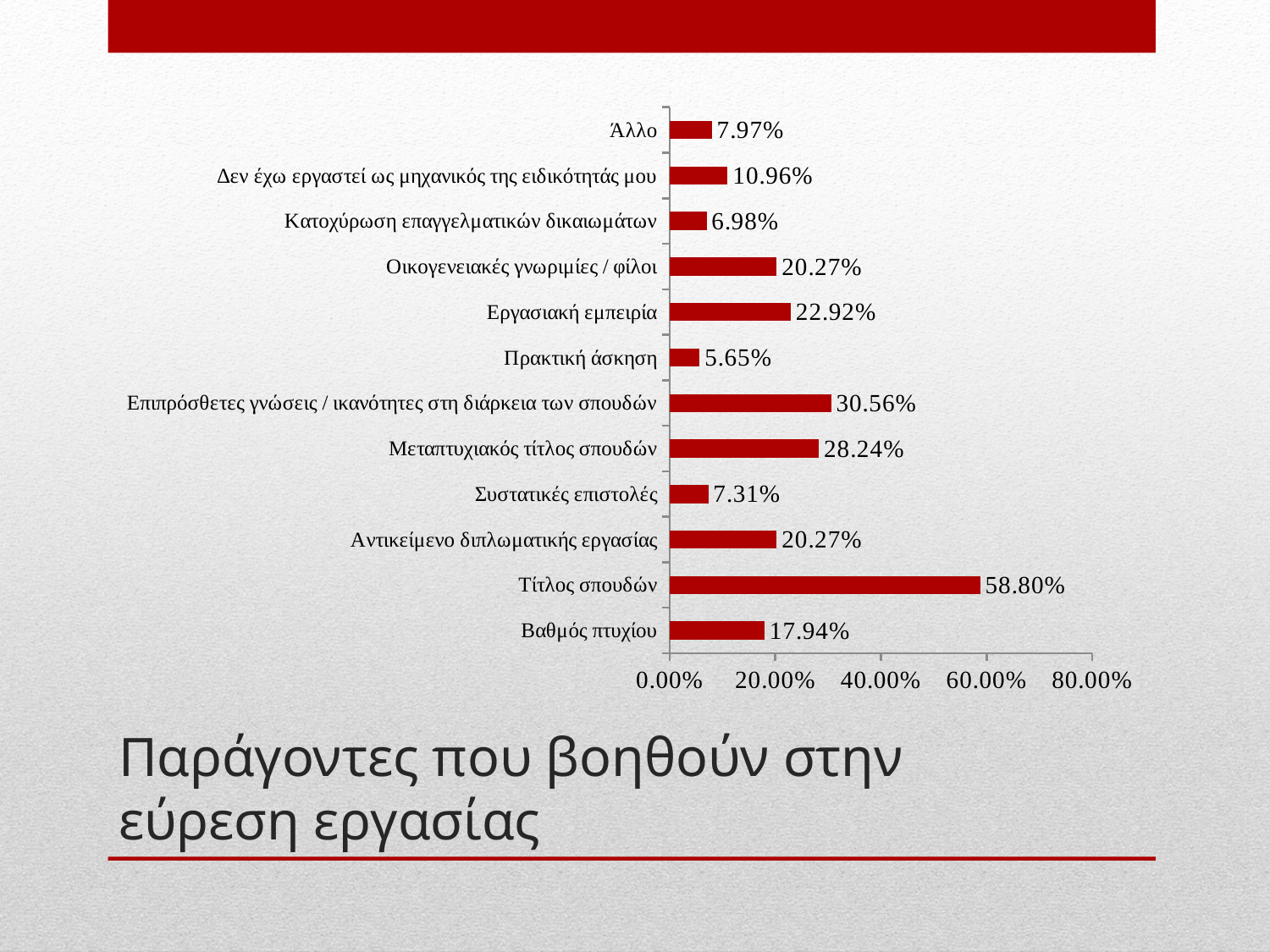
What is the difference between the values for Εργασιακή εμπειρία and Βαθμός πτυχίου? 4.98% What is the value for Εργασιακή εμπειρία? 22.92% Is the value for Τίτλος σπουδών greater or less than 40.00%? greater How many categories are shown in the chart? 12 Which is larger, the value for Μεταπτυχιακός τίτλος σπουδών or the value for Οικογενειακές γνωριμίες / φίλοι? Μεταπτυχιακός τίτλος σπουδών What kind of chart is shown on the slide? bar chart What is the value for Πρακτική άσκηση? 5.65% What is the value for Μεταπτυχιακός τίτλος σπουδών? 28.24% What is the difference between the values for Τίτλος σπουδών and Επιπρόσθετες γνώσεις / ικανότητες στη διάρκεια των σπουδών? 28.24% What is the value for Τίτλος σπουδών? 58.80% Which category has the lowest value? Πρακτική άσκηση Which category has the highest value? Τίτλος σπουδών